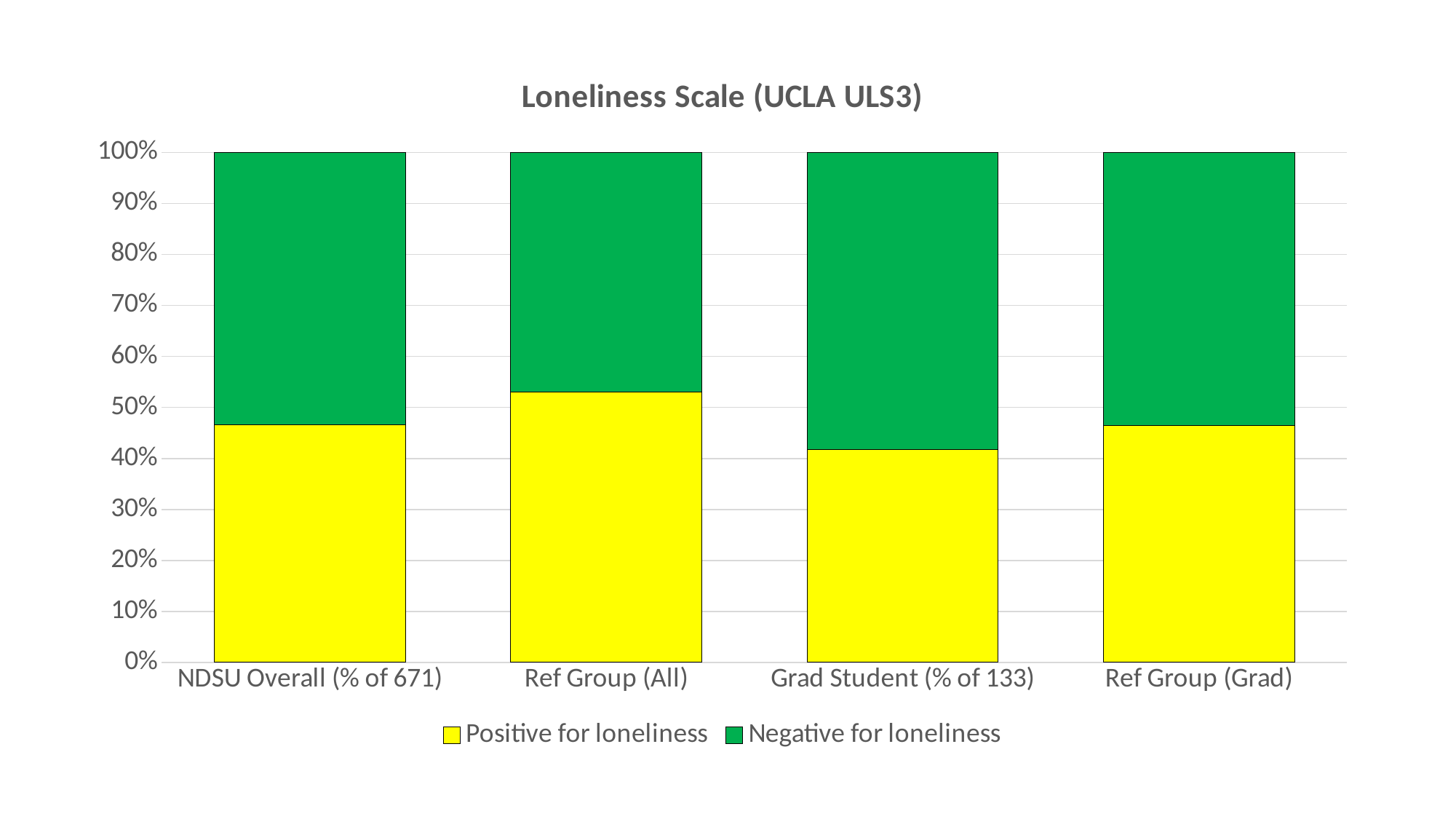
Is the 'Positive for loneliness' value for Grad Student (% of 133) greater or less than 50%? less Which has a larger 'Negative for loneliness' share: Grad Student (% of 133) or Ref Group (All)? Grad Student (% of 133) Which category has the highest share of 'Positive for loneliness'? Ref Group (All) Is the 'Positive for loneliness' value for NDSU Overall (% of 671) greater or less than 50%? less How many categories are shown on the x axis? 4 Which colour represents 'Positive for loneliness' in the chart? Yellow Which category has the lowest share of 'Positive for loneliness'? Grad Student (% of 133) What kind of chart is shown on the slide? Stacked bar chart Which has a larger 'Positive for loneliness' share: Ref Group (All) or Grad Student (% of 133)? Ref Group (All) What is the title of the chart? Loneliness Scale (UCLA ULS3) How many series does the legend list? 2 Is the 'Positive for loneliness' value for Ref Group (All) greater or less than 50%? greater